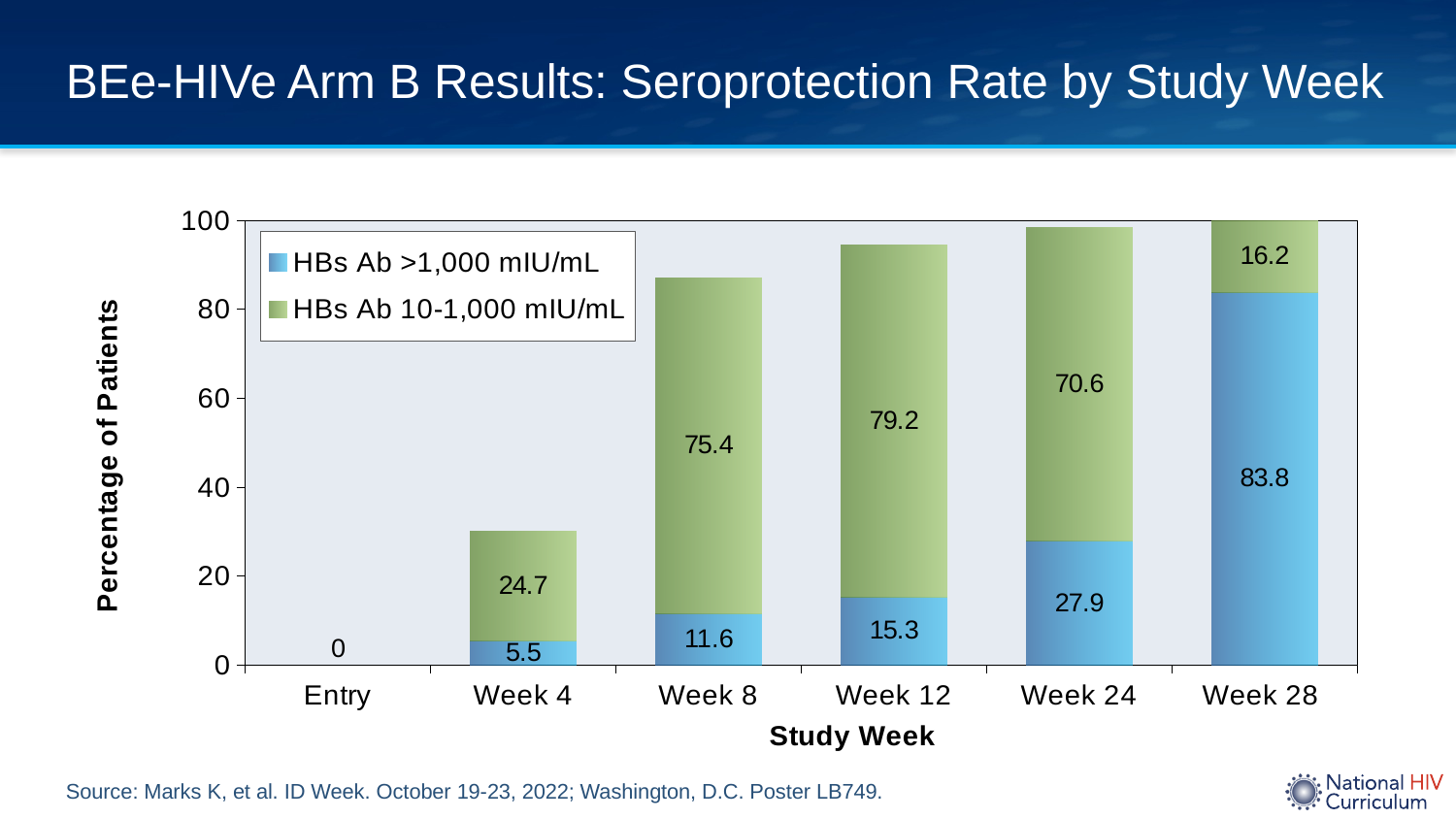
How many series does the legend list? 2 How many study week categories are shown on the x axis? 6 Does the HBs Ab >1,000 mIU/mL value rise or fall from Week 4 to Week 28? Rise At which study week is the HBs Ab 10-1,000 mIU/mL value lowest? Entry What is the difference between the HBs Ab >1,000 mIU/mL values at Week 24 and Week 12? 12.6 At which study week is the HBs Ab >1,000 mIU/mL value highest? Week 28 What kind of chart is shown on the slide? Stacked bar chart What is the total of the stacked bar at Week 4? 30.2 What is the value for HBs Ab 10-1,000 mIU/mL at Week 12? 79.2 Which is larger at Week 8: the HBs Ab >1,000 mIU/mL value or the HBs Ab 10-1,000 mIU/mL value? HBs Ab 10-1,000 mIU/mL What is the value for HBs Ab >1,000 mIU/mL at Week 28? 83.8 What is the value for HBs Ab >1,000 mIU/mL at Week 4? 5.5